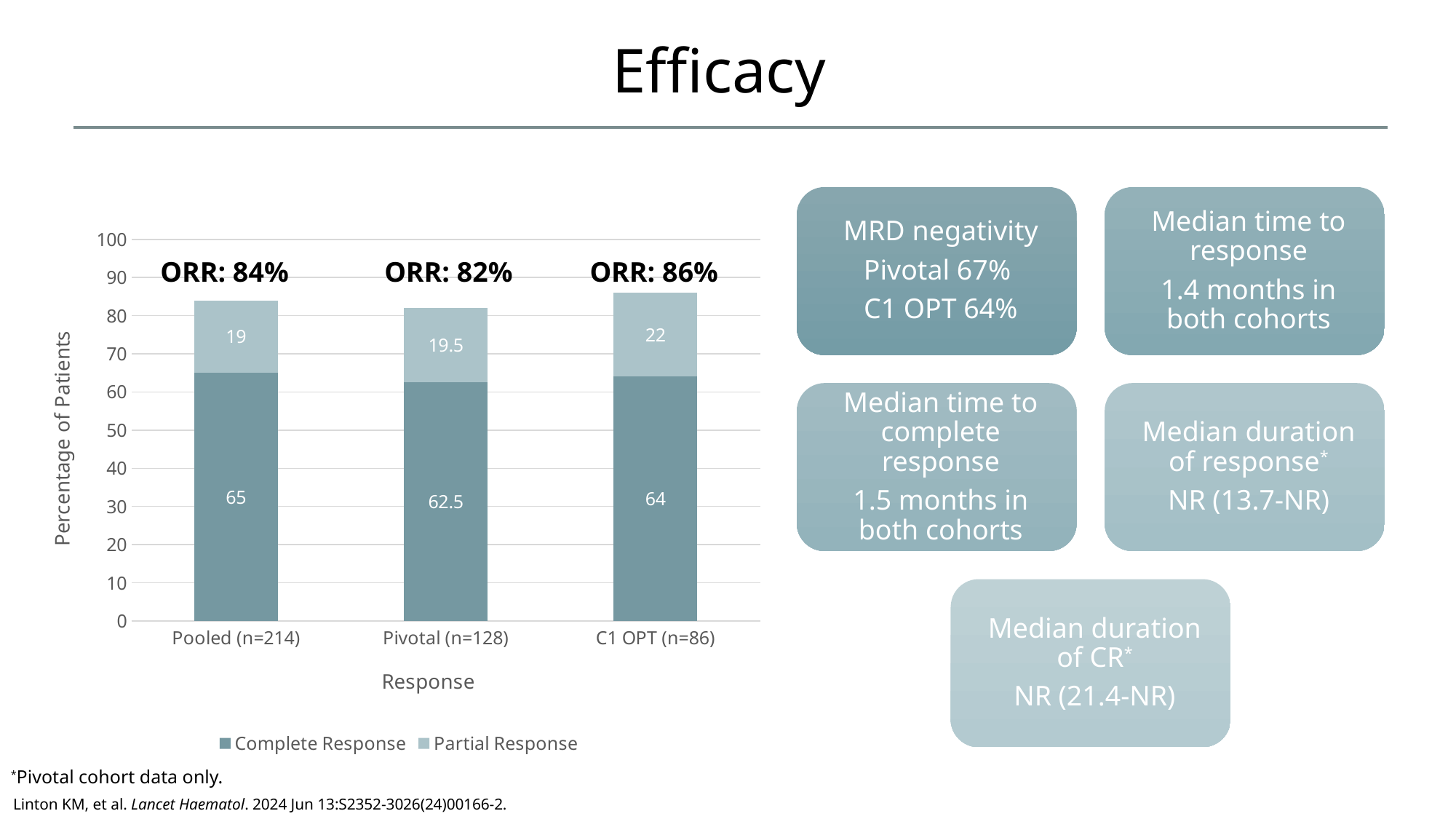
What is the difference between the Complete Response values for Pooled (n=214) and Pivotal (n=128)? 2.5 What is the total of the stacked bar for C1 OPT (n=86)? 86 How many groups are shown on the x axis of the chart? 3 Which group has the highest Partial Response value? C1 OPT (n=86) How many series does the chart legend list? 2 What is the ORR shown above the Pivotal (n=128) bar? 82% Which group has the lowest Complete Response value? Pivotal (n=128) What kind of chart is shown on the slide? Stacked bar chart What is the Complete Response value for the Pooled (n=214) group? 65 What is the Complete Response value for the C1 OPT (n=86) group? 64 Which is larger: the Partial Response value for Pooled (n=214) or for C1 OPT (n=86)? C1 OPT (n=86) What is the Partial Response value for the Pivotal (n=128) group? 19.5